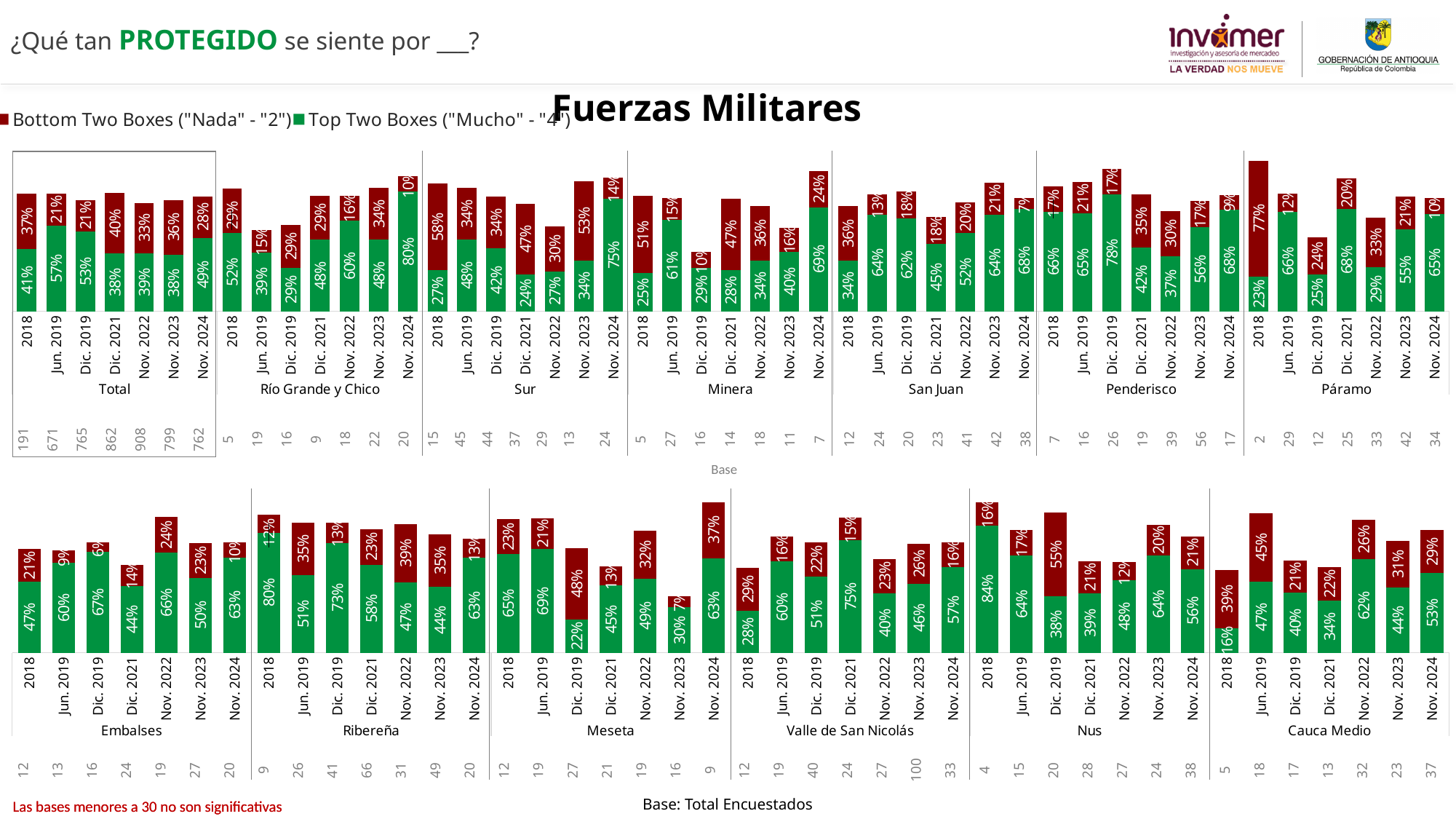
How many series does the legend list? 2 In the top chart, what is the total of the Nov. 2024 stacked bar for Sur (Top Two Boxes plus Bottom Two Boxes)? 89% In the top chart, which period has the highest Top Two Boxes value for Río Grande y Chico? Nov. 2024 In the bottom chart, which is larger for Ribereña in Nov. 2022: Top Two Boxes or Bottom Two Boxes? Top Two Boxes What kind of chart is shown on the slide? Stacked bar chart In the bottom chart, which period has the lowest Top Two Boxes value for Cauca Medio? 2018 In the bottom chart, what is the Top Two Boxes value for Nus in 2018? 84% In the top chart, what is the Top Two Boxes value for Total in Nov. 2024? 49% In the bottom chart, what is the Bottom Two Boxes value for Meseta in Dic. 2019? 48% How many periods are plotted for each region in the bottom chart? 7 In the top chart, what is the difference between the Top Two Boxes values for Penderisco in Dic. 2019 and Nov. 2022? 41% In the top chart, what is the Bottom Two Boxes value for Páramo in 2018? 77%